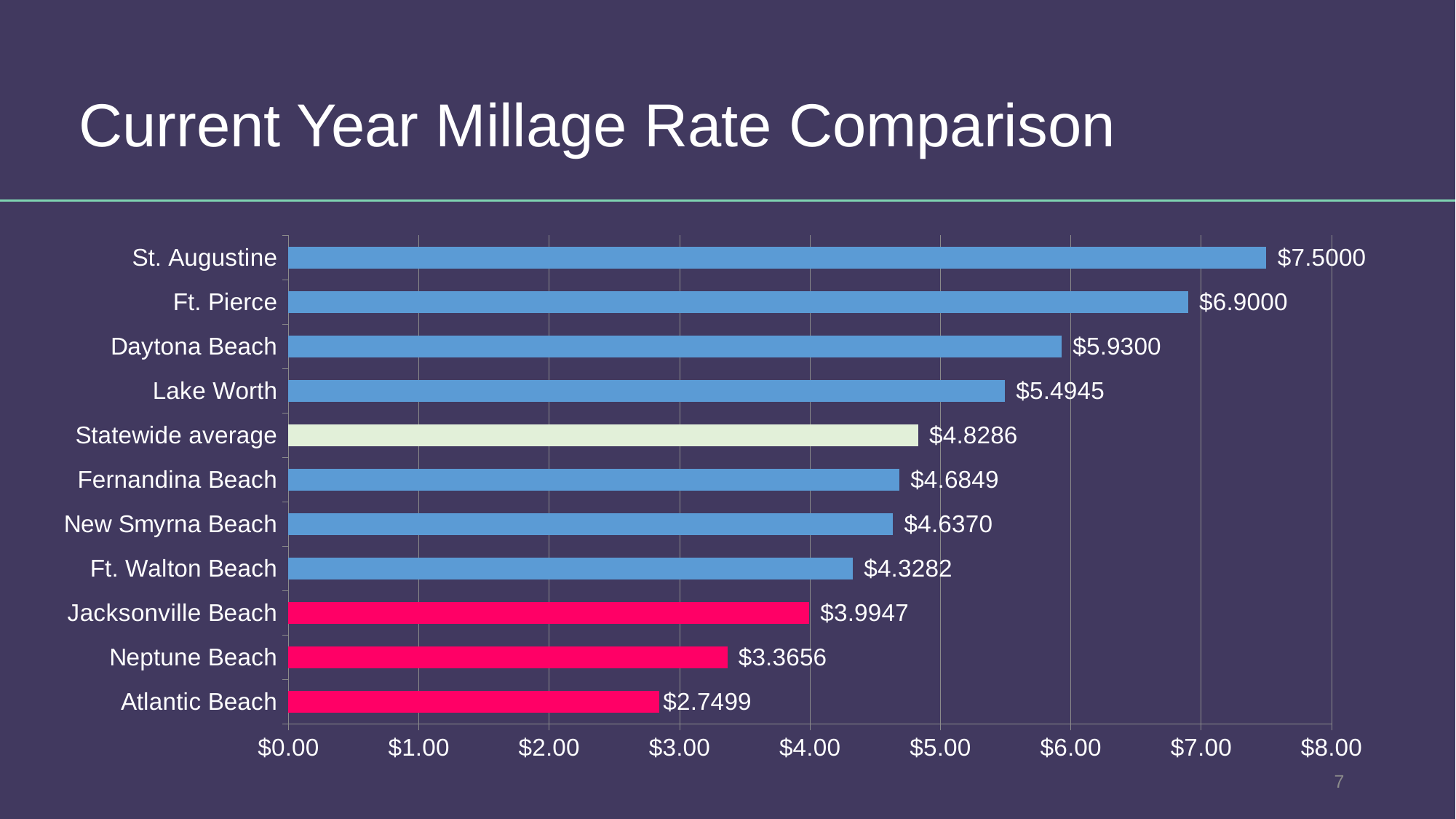
Which category has the lowest millage rate? Atlantic Beach Is the value for Ft. Pierce greater or less than $6.00? greater What is the difference between the millage rates of St. Augustine and Atlantic Beach? $4.7501 What is the millage rate shown for Neptune Beach? $3.3656 What is the difference between the millage rates of Jacksonville Beach and Neptune Beach? $0.6291 What is the millage rate shown for St. Augustine? $7.5000 Which category has the highest millage rate? St. Augustine What kind of chart is shown on the slide? Bar chart Which has a higher millage rate, Daytona Beach or Lake Worth? Daytona Beach What is the title of the slide? Current Year Millage Rate Comparison How many categories are shown in the chart? 11 What is the value shown for the Statewide average? $4.8286